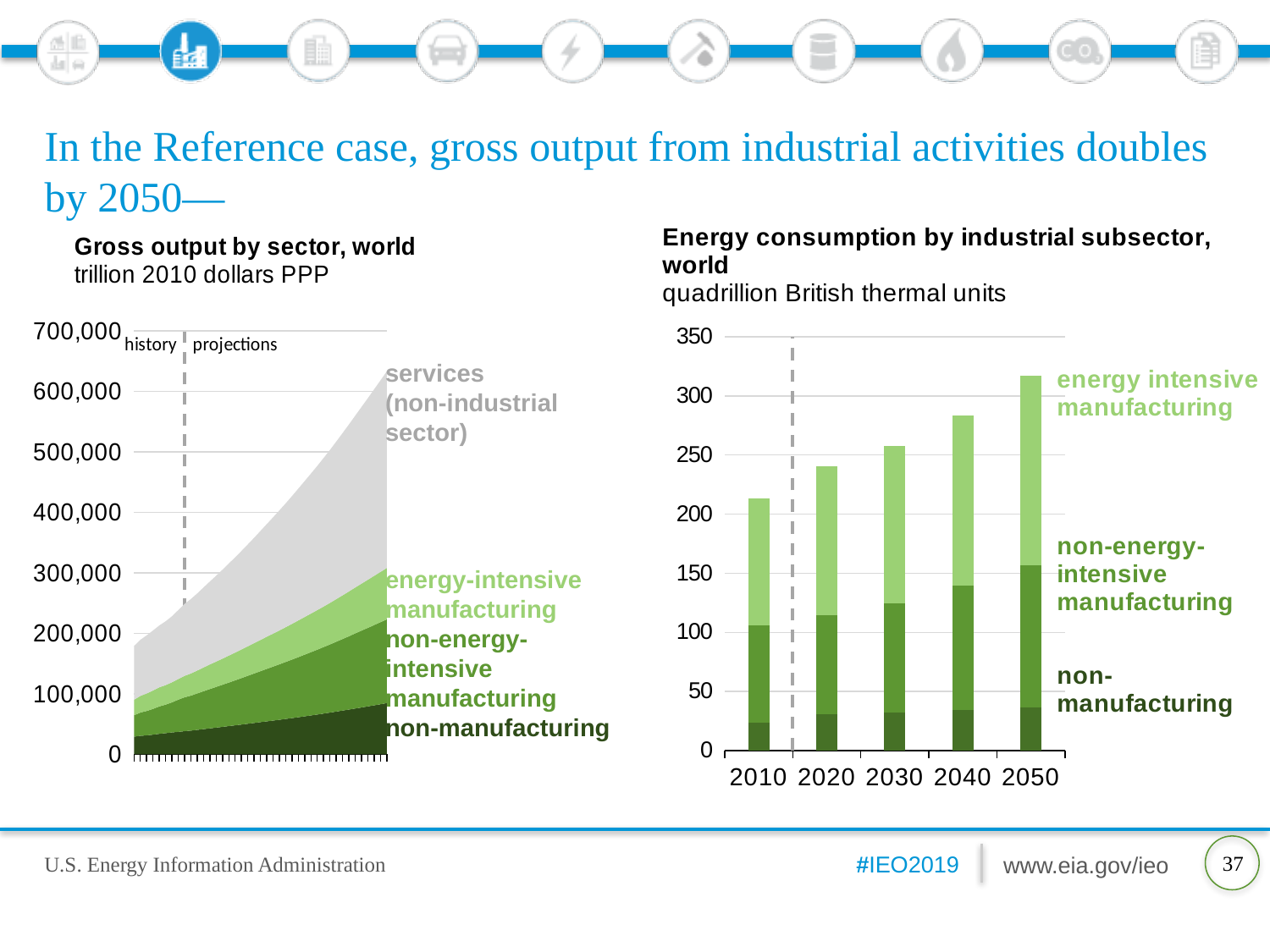
What kind of chart is the 'Energy consumption by industrial subsector, world' chart? bar chart In the 'Energy consumption by industrial subsector, world' chart, which year has the highest total energy consumption? 2050 What unit is used on the 'Gross output by sector, world' chart? trillion 2010 dollars PPP In the 'Energy consumption by industrial subsector, world' chart, which year has the lowest total energy consumption? 2010 In the 'Gross output by sector, world' chart, how many sectors are shown? 4 What unit is used on the 'Energy consumption by industrial subsector, world' chart? quadrillion British thermal units What kind of chart is the 'Gross output by sector, world' chart? area chart In the 'Energy consumption by industrial subsector, world' chart, how many years are shown on the x axis? 5 In the 'Energy consumption by industrial subsector, world' chart, is the total for 2010 greater or less than 250? less In the 'Energy consumption by industrial subsector, world' chart, is the total for 2050 greater or less than 300? greater In the 'Energy consumption by industrial subsector, world' chart, how many subsectors are stacked in each bar? 3 In the 'Energy consumption by industrial subsector, world' chart, does total energy consumption rise or fall from 2010 to 2050? rise